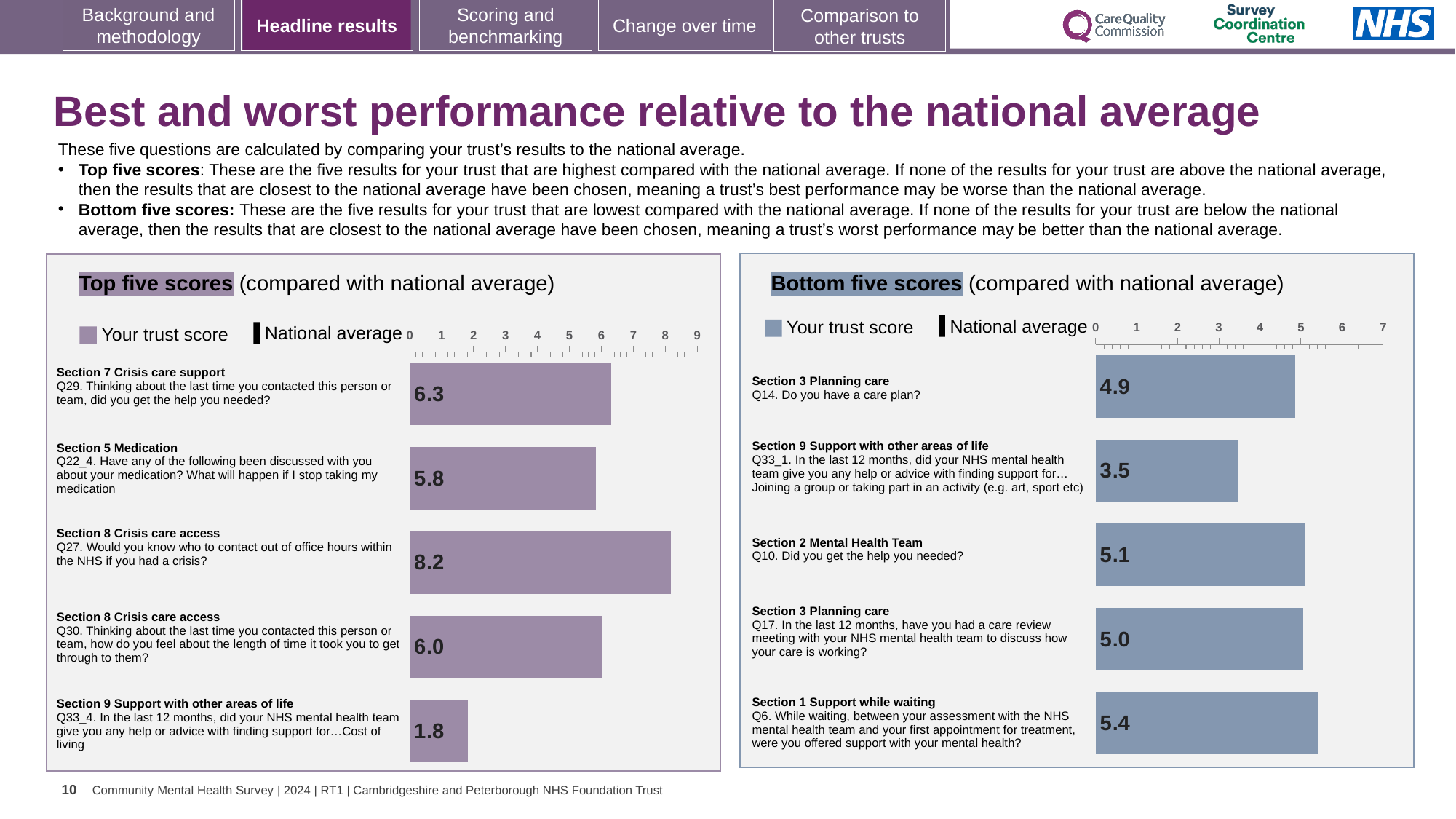
In the Top five scores chart, how many questions are plotted? 5 In the Bottom five scores chart, what is the maximum value shown on the horizontal axis? 7 In the Top five scores chart, what is the trust score for Q27 (Section 8 Crisis care access)? 8.2 In the Bottom five scores chart, what is the difference between the trust scores for Q6 and Q33_1? 1.9 In the Top five scores chart, what is the difference between the trust scores for Q27 and Q30? 2.2 In the Bottom five scores chart, which question has the lowest trust score? Q33_1 (Joining a group or taking part in an activity) In the Bottom five scores chart, which question has the highest trust score? Q6 (Section 1 Support while waiting) In the Bottom five scores chart, what is the trust score for Q14 (Do you have a care plan?)? 4.9 In the Top five scores chart, what is the trust score for Q29 (Section 7 Crisis care support)? 6.3 What type of chart is used for the Top five scores? Bar chart In the Bottom five scores chart, is the trust score for Q10 larger or smaller than the trust score for Q17? larger In the Top five scores chart, which question has the lowest trust score? Q33_4 (Cost of living)